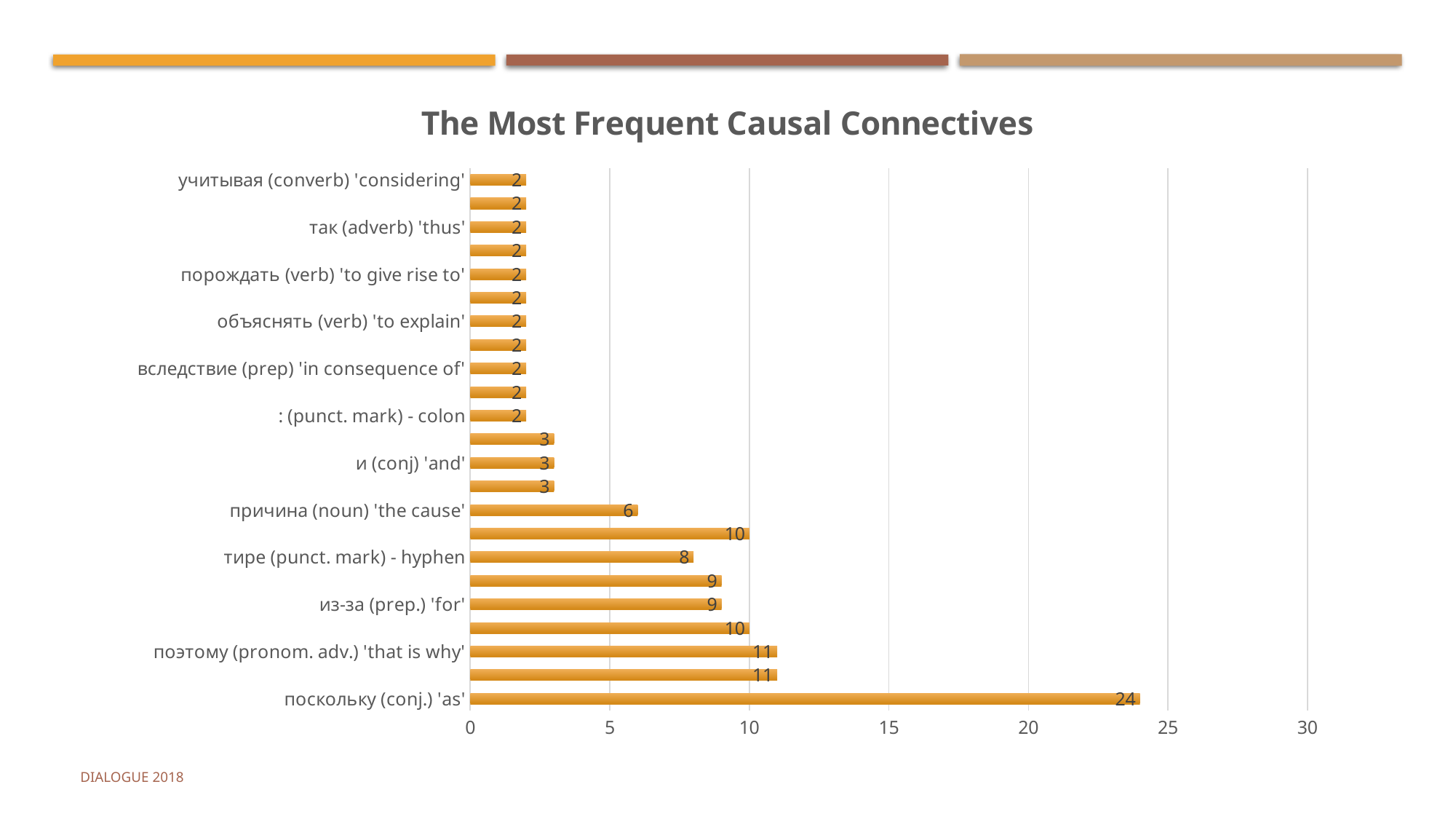
What is the value for причина (noun) 'the cause'? 6 What type of chart is shown on the slide? bar chart What is the value for и (conj) 'and'? 3 What is the difference between the values for поскольку (conj.) 'as' and поэтому (pronom. adv.) 'that is why'? 13 What is the value for тире (punct. mark) - hyphen? 8 Which has a larger value, тире (punct. mark) - hyphen or из-за (prep.) 'for'? из-за (prep.) 'for' What is the title of the chart? The Most Frequent Causal Connectives What is the value for из-за (prep.) 'for'? 9 What is the value for поэтому (pronom. adv.) 'that is why'? 11 Is the value for поскольку (conj.) 'as' greater or less than 20? greater Which connective has the highest value? поскольку (conj.) 'as' What is the value for поскольку (conj.) 'as'? 24